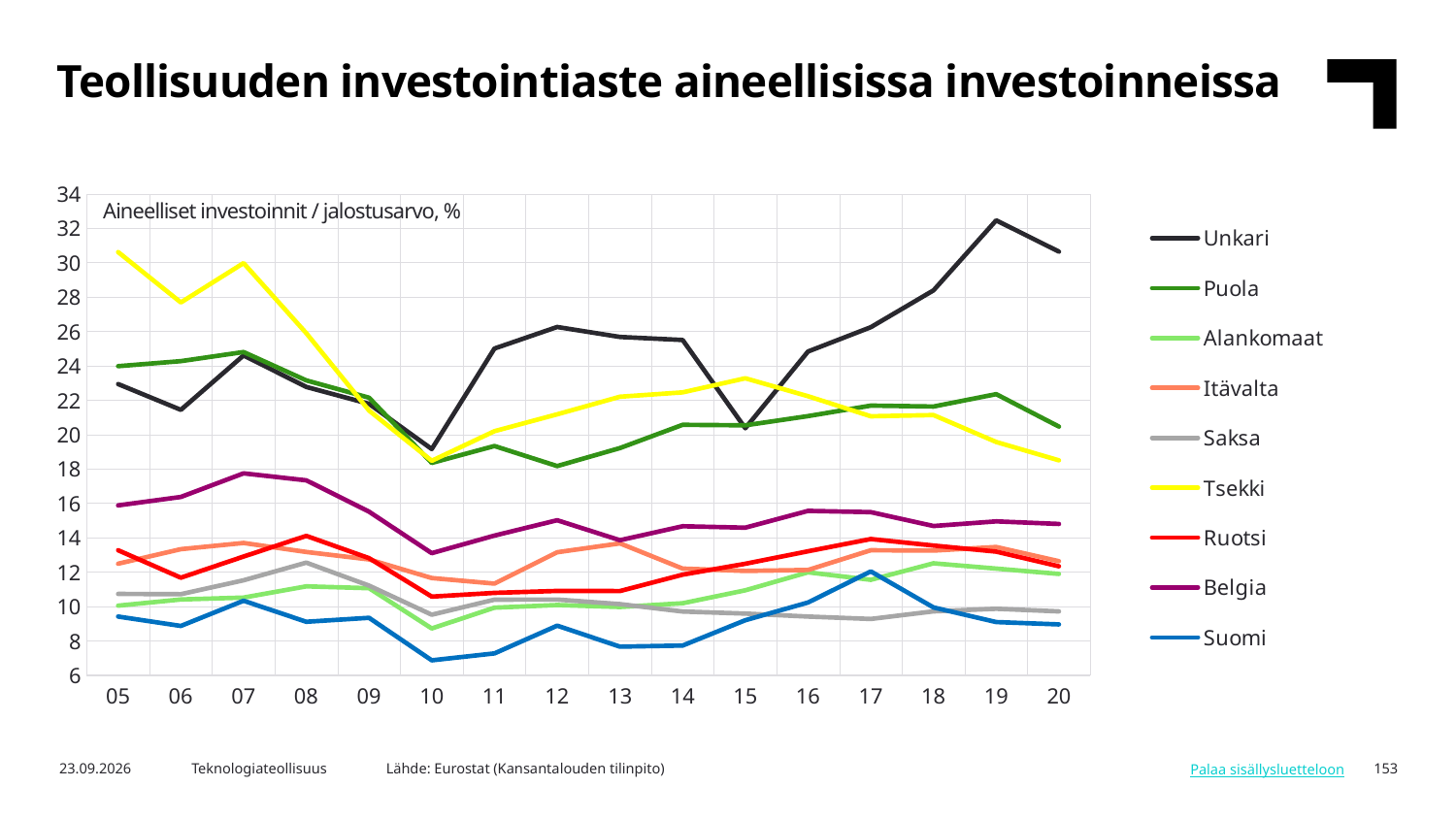
In 17, which is higher: Puola or Alankomaat? Puola In 05, which is higher: Tsekki or Unkari? Tsekki Is the value for Tsekki in 20 greater or less than 20? less Is the value for Suomi in 10 greater or less than 8? less Which series has the lowest value in 10? Suomi Which series has the highest value in 20? Unkari How many years are shown along the x axis? 16 How many series does the legend list? 9 Does the Unkari line rise or fall from 15 to 19? rises Is the value for Unkari in 19 greater or less than 30? greater What label is printed inside the plot area at the top left? Aineelliset investoinnit / jalostusarvo, % What kind of chart is shown on the slide? line chart